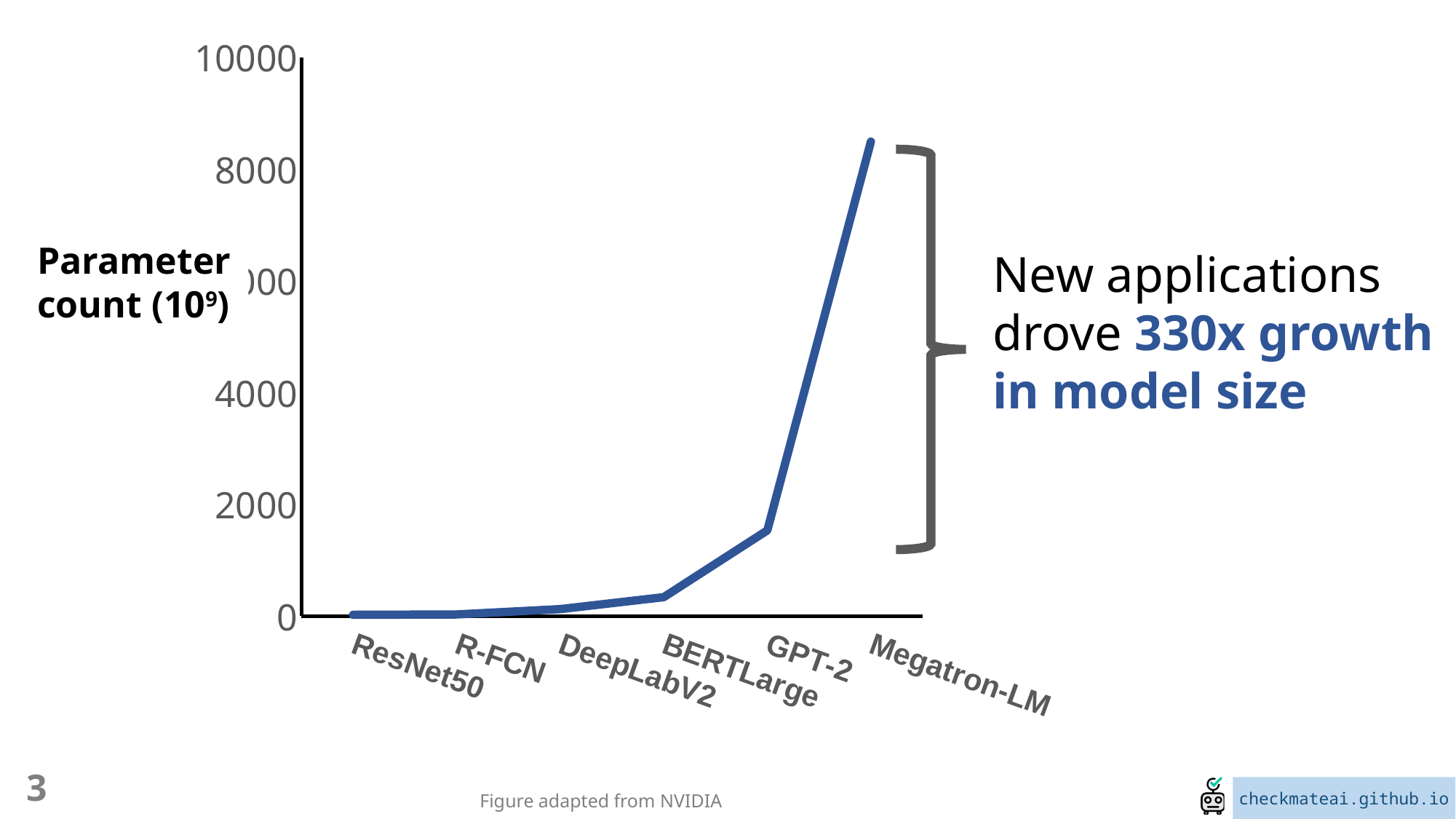
How many models are plotted along the x axis? 6 What is the label of the y axis? Parameter count (10⁹) Is the parameter count for BERTLarge greater or less than 2000? less Which has a larger parameter count, GPT-2 or Megatron-LM? Megatron-LM Which has a larger parameter count, BERTLarge or GPT-2? GPT-2 According to the annotation next to the chart, how much growth in model size did new applications drive? 330x growth Is the parameter count for Megatron-LM greater or less than 10000? less Is the parameter count for Megatron-LM greater or less than 8000? greater Do the parameter counts rise or fall moving from ResNet50 to Megatron-LM along the x axis? rise Which model has the highest parameter count? Megatron-LM What kind of chart is shown on the slide? line chart